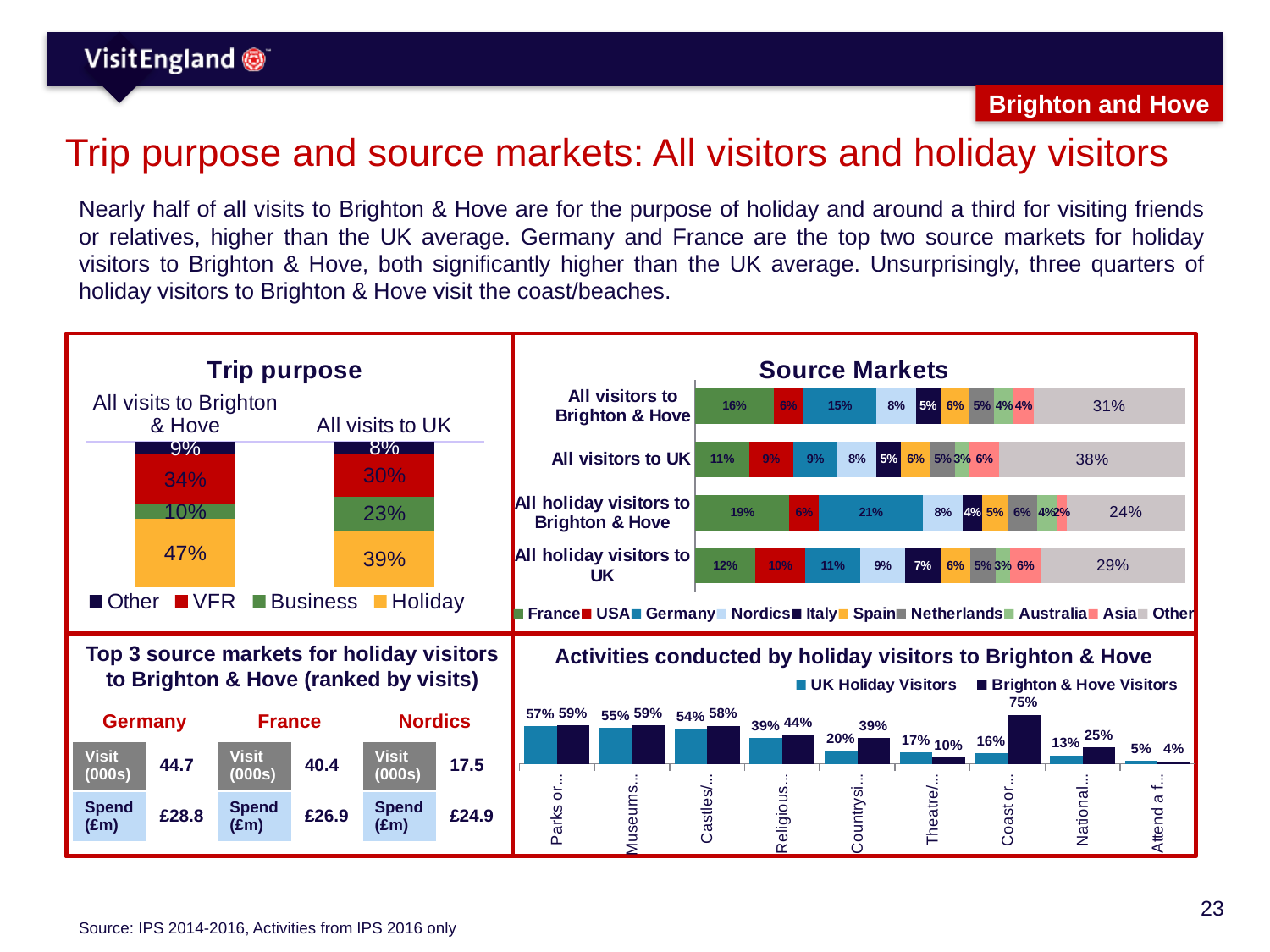
In the Activities chart, which activity has the highest value for Brighton & Hove Visitors? Coast In the Trip purpose chart, what is the difference between the VFR share for all visits to Brighton & Hove and for all visits to the UK? 4% In the Activities chart, is the Theatre value larger for UK Holiday Visitors or Brighton & Hove Visitors? UK Holiday Visitors How many series does the legend of the Source Markets chart list? 10 In the Activities chart, what percentage of Brighton & Hove holiday visitors visit the coast? 75% What kind of chart is the Activities conducted by holiday visitors to Brighton & Hove chart? Bar chart In the Trip purpose chart, what percentage of all visits to Brighton & Hove are for Holiday? 47% In the Trip purpose chart, what is the Business share for all visits to the UK? 23% In the Source Markets chart, what is the Germany share for all holiday visitors to Brighton & Hove? 21% In the Source Markets chart, which bar has the largest France share? All holiday visitors to Brighton & Hove In the Source Markets chart, what is the Other share for all visitors to the UK? 38% How many series does the legend of the Trip purpose chart list? 4